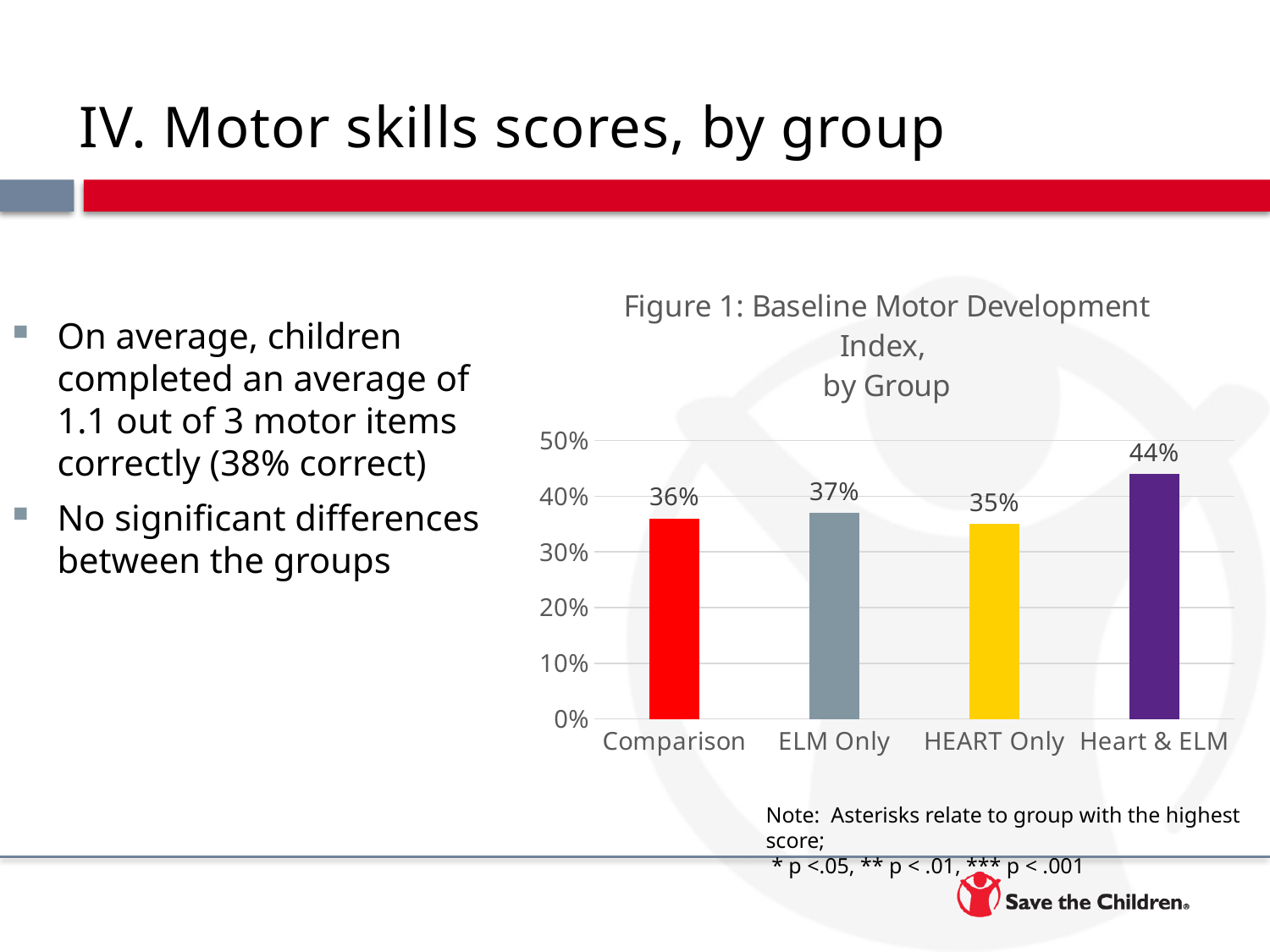
What is the difference between the Heart & ELM value and the Comparison value? 8% Which group has the lowest Baseline Motor Development Index? HEART Only What is the value for the Heart & ELM group? 44% Which is larger, the value for Heart & ELM or the value for ELM Only? Heart & ELM What kind of chart is shown on the slide? Bar chart How many groups are shown on the chart? 4 Which group has the highest Baseline Motor Development Index? Heart & ELM What is the value for the Comparison group? 36% What is the title of the chart? Figure 1: Baseline Motor Development Index, by Group What is the difference between the ELM Only value and the HEART Only value? 2% What is the value for the ELM Only group? 37% What is the value for the HEART Only group? 35%